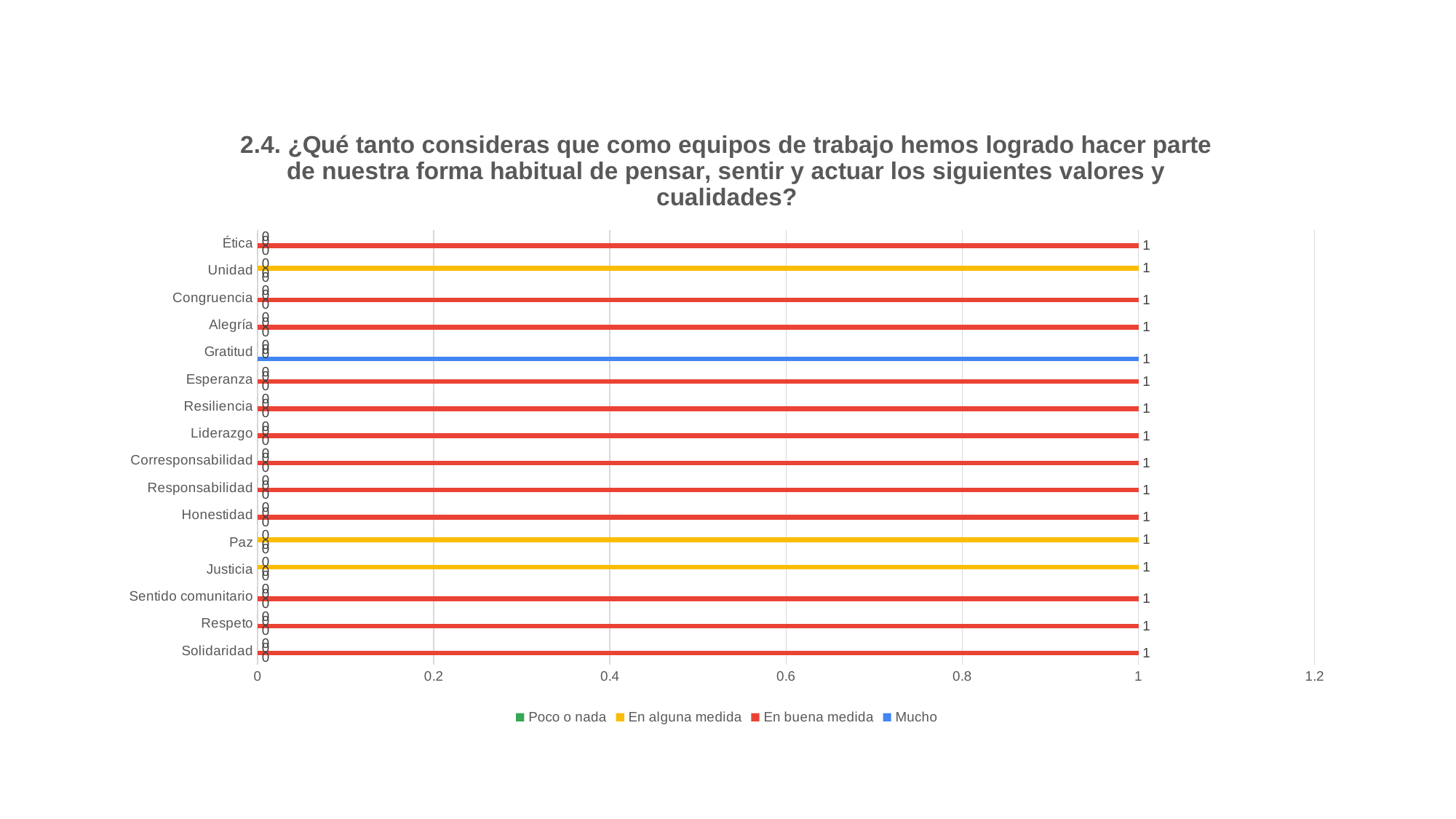
How many series does the legend list? 4 Is the 'En buena medida' value for Honestidad greater or less than 0.8? greater What is the value of the 'En alguna medida' series for Unidad? 1 How many categories are plotted on the chart? 16 What is the value of the 'En buena medida' series for Ética? 1 Which is larger for Respeto: the 'En buena medida' value or the 'Mucho' value? En buena medida Which series has the value 1 for Justicia? En alguna medida What is the value of the 'Mucho' series for Gratitud? 1 Which series has the value 1 for Paz? En alguna medida What is the difference between the 'En buena medida' value and the 'Poco o nada' value for Liderazgo? 1 What is the value of the 'Poco o nada' series for Solidaridad? 0 What kind of chart is shown on the slide? bar chart